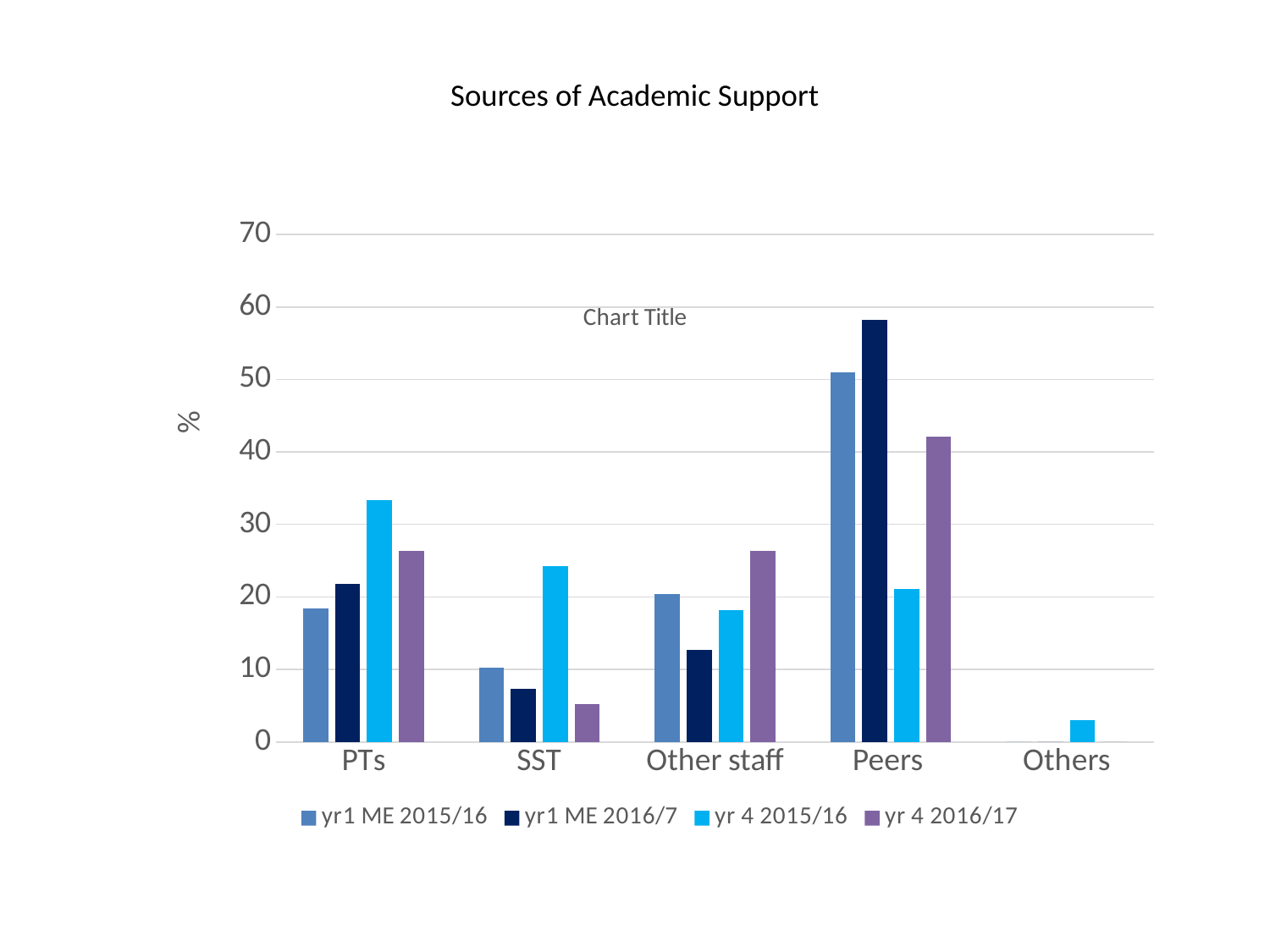
For the yr1 ME 2016/7 series, which category has the highest value? Peers Is the yr 4 2016/17 value for SST greater or less than 10? less What is the label on the vertical axis? % For the yr 4 2016/17 series, which category has the highest value? Peers How many categories are shown on the x axis? 5 For PTs, which is larger: the yr 4 2015/16 value or the yr 4 2016/17 value? yr 4 2015/16 For Peers, which is larger: the yr1 ME 2015/16 value or the yr 4 2016/17 value? yr1 ME 2015/16 What kind of chart is shown on the slide? bar chart For the yr 4 2015/16 series, which category has the lowest value? Others Is the yr1 ME 2016/7 value for Peers greater or less than 50? greater How many series does the legend list? 4 Is the yr 4 2015/16 value for PTs greater or less than 30? greater